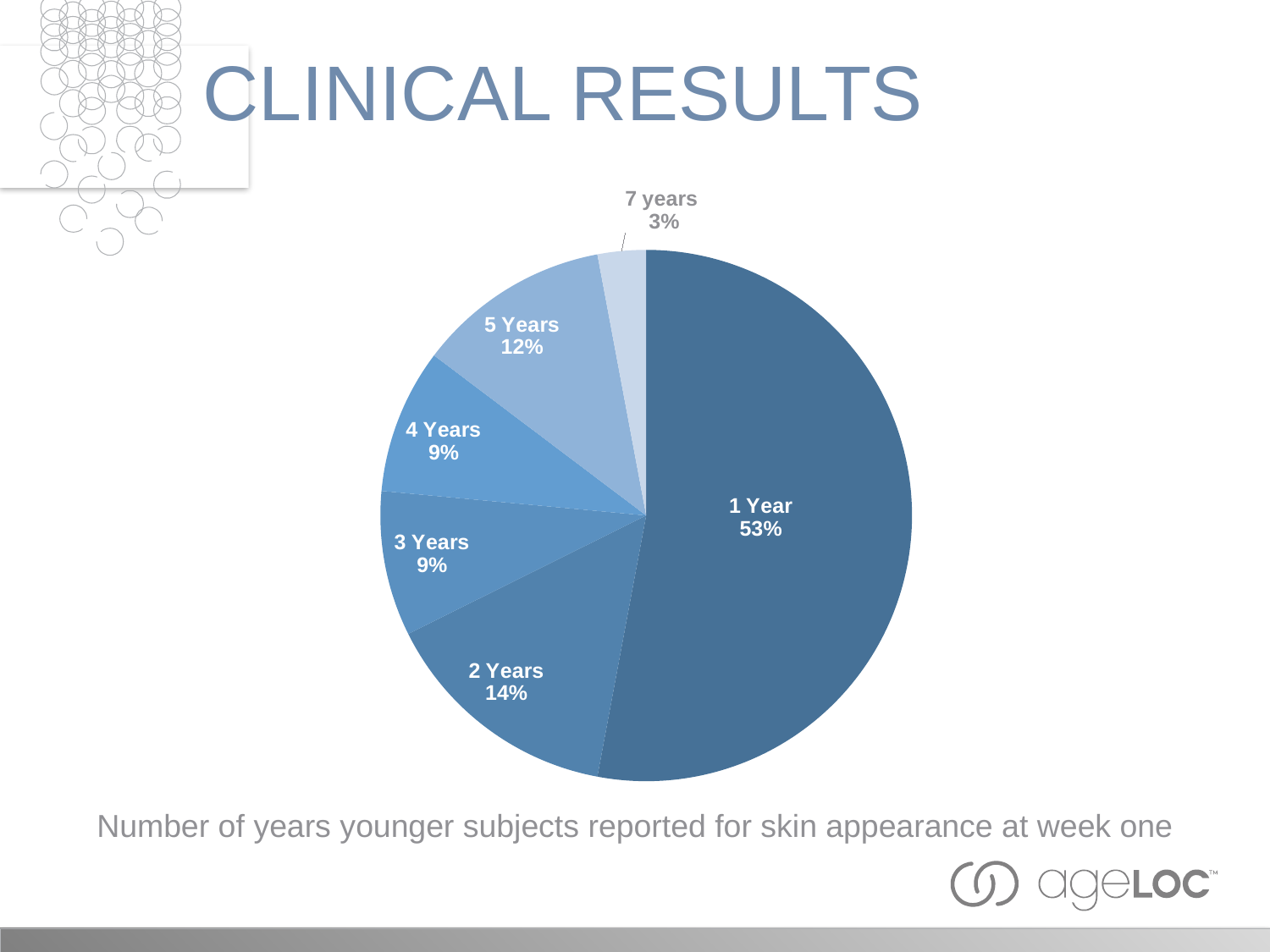
Which slice of the pie is the largest? 1 Year What percentage is shown for the 2 Years slice? 14% What percentage is shown for the 5 Years slice? 12% What is the title of the slide containing the pie chart? CLINICAL RESULTS How many slices does the pie chart have? 6 What is the combined percentage of the 3 Years and 4 Years slices? 18% What share of the pie does the 1 Year slice represent? 53% What is the difference in percentage points between the 1 Year slice and the 2 Years slice? 39 Which slice of the pie is the smallest? 7 years Which is larger, the 5 Years slice or the 4 Years slice? 5 Years What percentage is shown for the 7 years slice? 3% What kind of chart is shown on the slide? pie chart